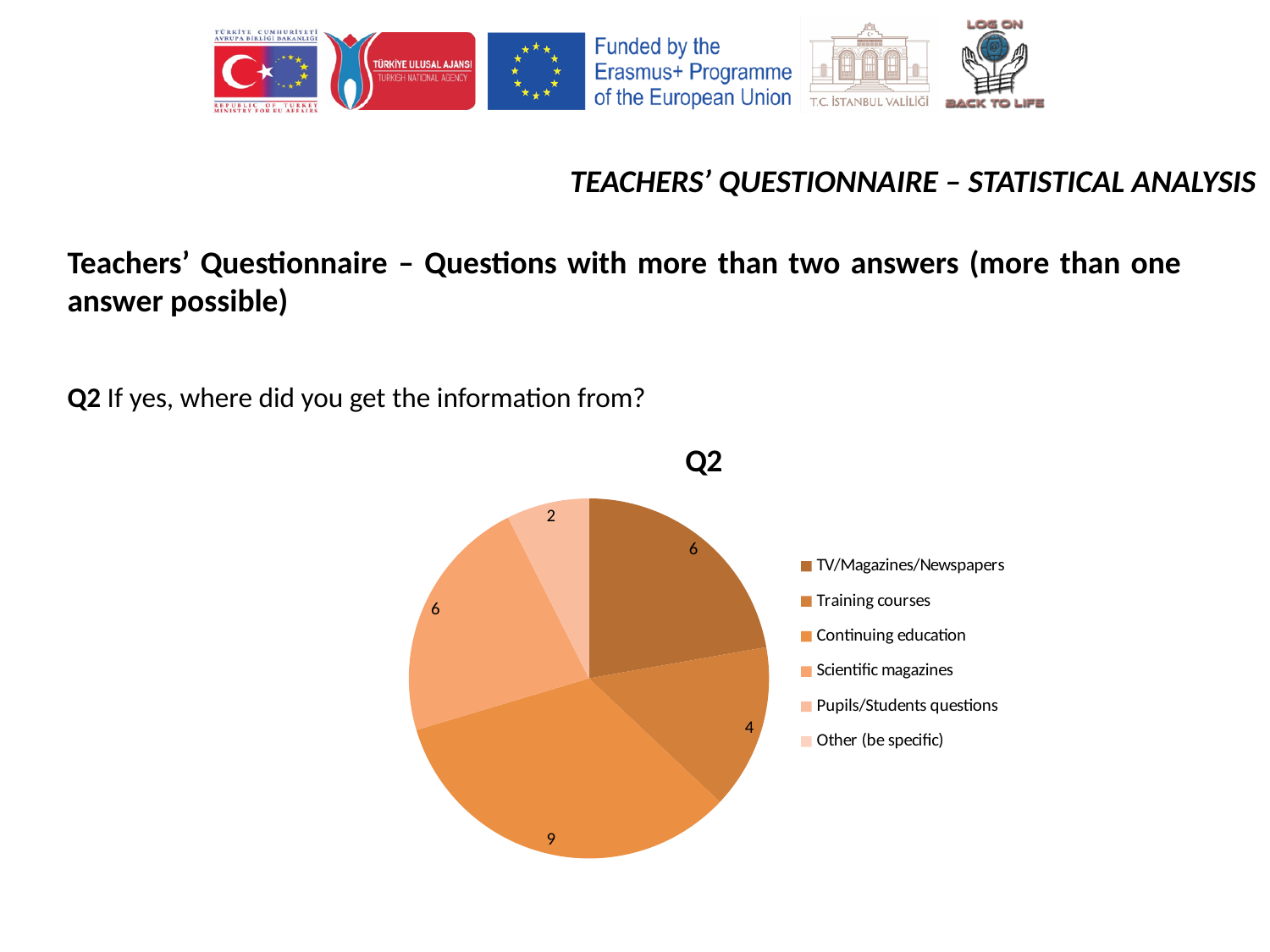
Which is larger, the value for Continuing education or the value for TV/Magazines/Newspapers? Continuing education What is the title of the chart? Q2 What is the value for Training courses? 4 What is the difference between the values for TV/Magazines/Newspapers and Training courses? 2 Which is larger, the value for Training courses or the value for TV/Magazines/Newspapers? TV/Magazines/Newspapers What type of chart is shown on the slide? Pie chart What is the value for TV/Magazines/Newspapers? 6 Which category has the largest slice of the pie? Continuing education What is the value for Continuing education? 9 What is the smallest value labelled on the pie chart? 2 How many categories does the chart's legend list? 6 What is the difference between the values for Continuing education and Training courses? 5